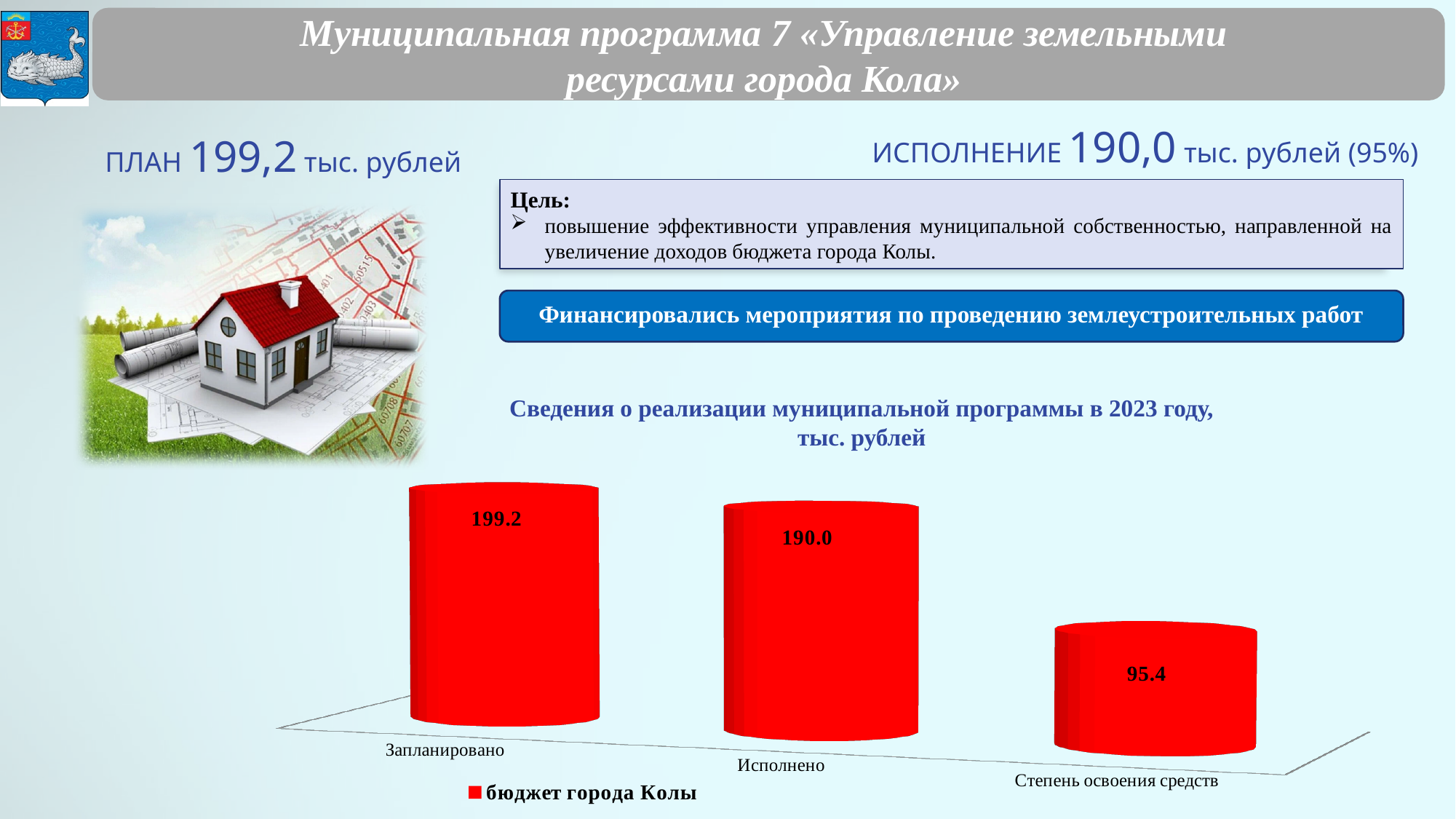
Which category has the lowest value? Степень освоения средств How many series does the legend list? 1 What is the value for Исполнено? 190.0 What is the legend entry of the chart? бюджет города Колы What is the value for Степень освоения средств? 95.4 Which category has the highest value? Запланировано What is the value for Запланировано? 199.2 What is the difference between the values for Исполнено and Степень освоения средств? 94.6 Which is larger, the value for Исполнено or the value for Степень освоения средств? Исполнено What is the difference between the values for Запланировано and Исполнено? 9.2 What kind of chart is shown on the slide? Bar chart How many categories are shown in the chart? 3